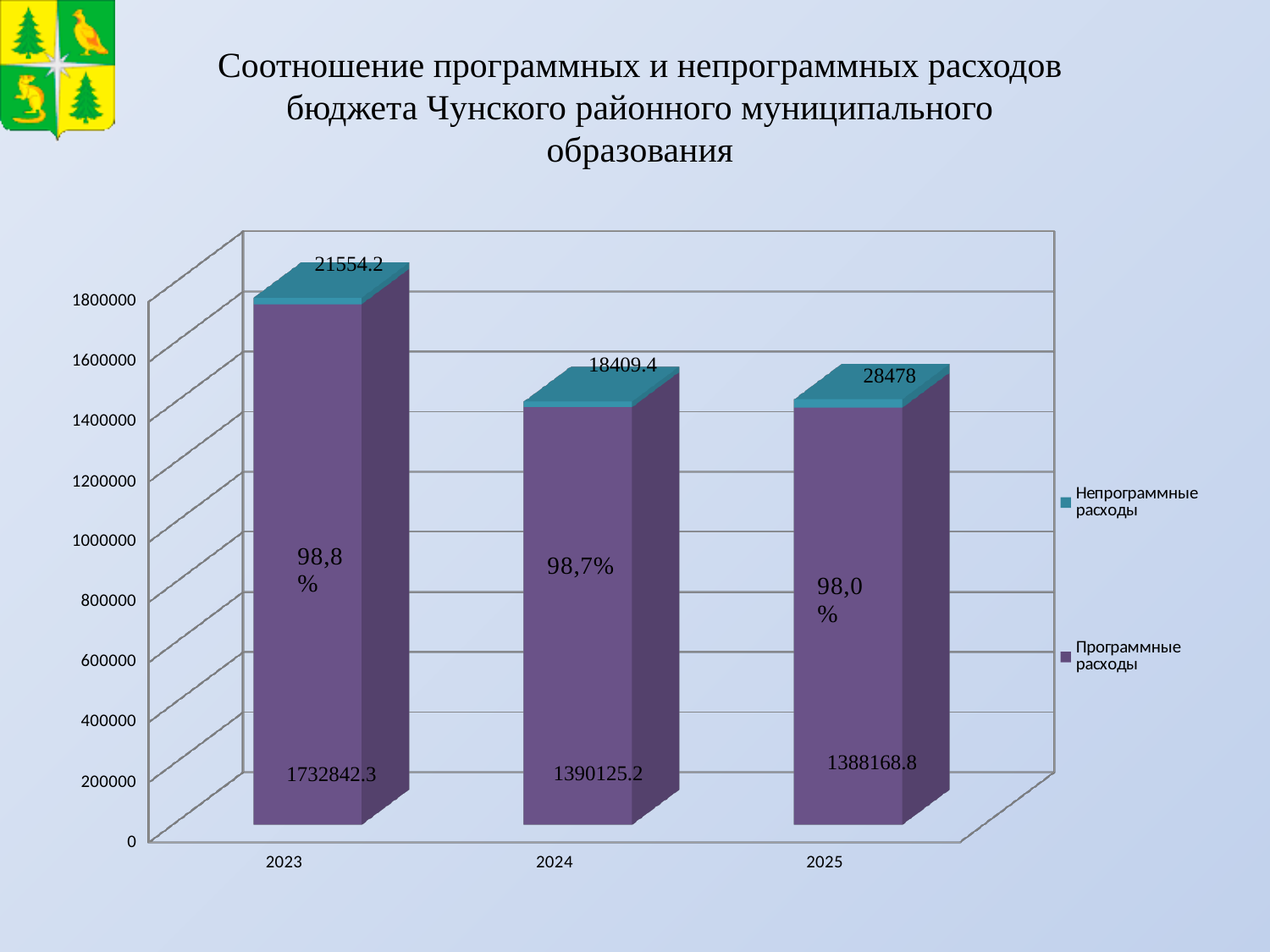
In which year is Программные расходы the highest? 2023 What kind of chart is shown on the slide? Stacked bar chart In which year is Непрограммные расходы the lowest? 2024 What percentage label is shown on the 2024 bar? 98,7% What is the value of Непрограммные расходы for 2025? 28478 What is the total of the stacked bar for 2024? 1408534.6 What is the value of Программные расходы for 2023? 1732842.3 How many series does the legend list? 2 What is the value of Непрограммные расходы for 2024? 18409.4 In which year is Непрограммные расходы the highest? 2025 How many years are shown on the x axis? 3 What is the difference between Программные расходы in 2023 and 2024? 342717.1